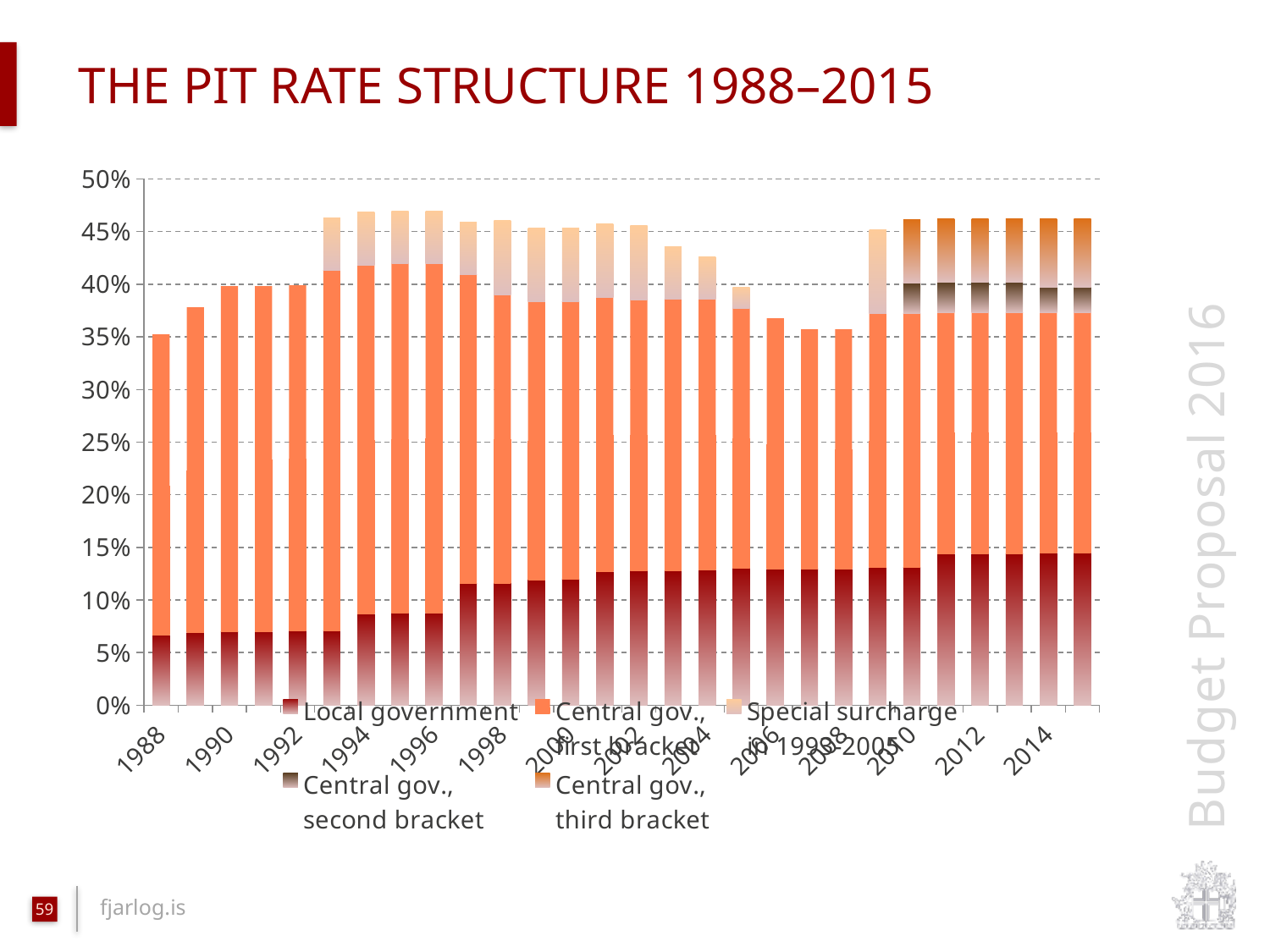
Does the total PIT rate rise or fall from 1988 to 1991? rise Is the local government rate for 2015 greater or less than 10%? greater How many series does the legend list? 5 Is the total PIT rate for 2008 greater or less than 40%? less How many years (bars) are plotted in the chart? 28 What is the title of the chart on the slide? THE PIT RATE STRUCTURE 1988–2015 Is the total PIT rate for 1995 greater or less than 45%? greater Which year has the larger total PIT rate, 1988 or 1995? 1995 Which year has the larger total PIT rate, 2005 or 2007? 2005 What kind of chart is shown on the slide? Stacked bar chart